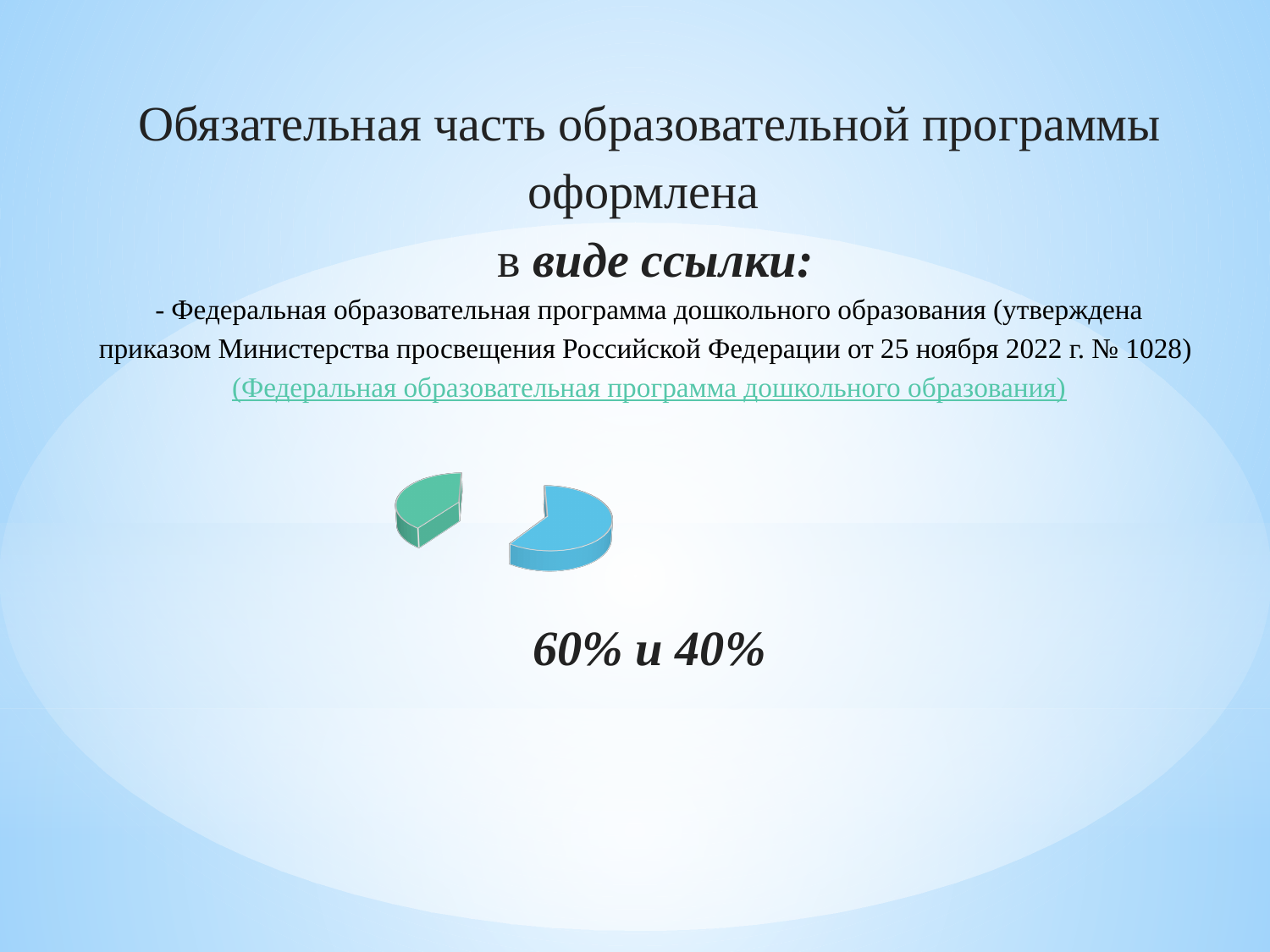
What colours are the two slices of the pie chart? green and blue How many slices does the pie chart have? 2 What share of the pie does the larger (blue) slice represent, according to the text under the chart? 60% Which slice of the pie chart is the smallest? the green slice What two percentages are printed below the pie chart? 60% и 40% What kind of chart is shown on the slide? pie chart Which slice of the pie chart is larger, the blue one or the green one? the blue one Which slice of the pie chart is the largest? the blue slice What share of the pie does the smaller (green) slice represent, according to the text under the chart? 40%